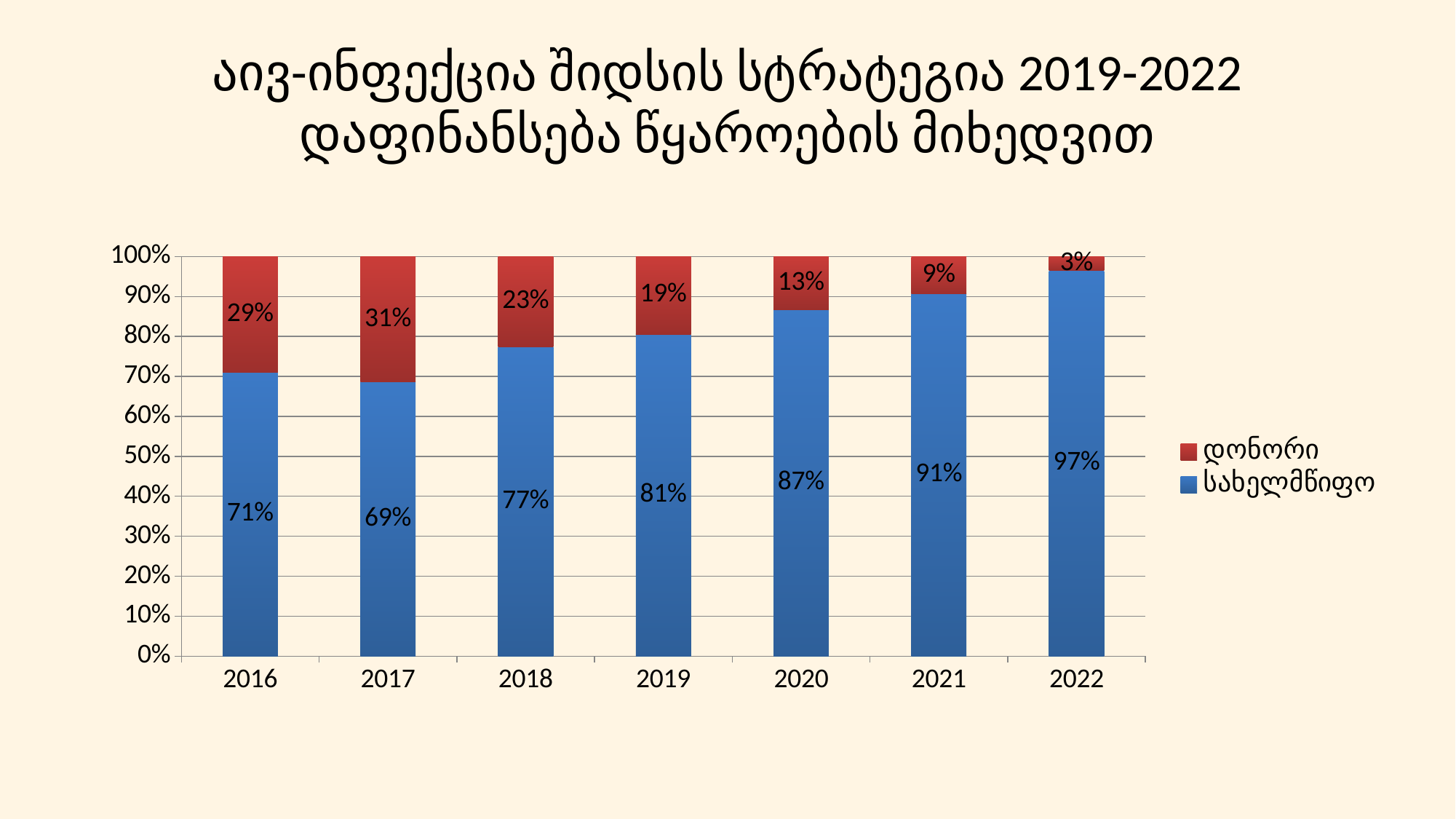
How many years are shown on the x axis? 7 Which is larger: the დონორი value in 2018 or in 2019? 2018 In which year is the სახელმწიფო share highest? 2022 Does the დონორი share rise or fall from 2017 to 2022? Fall What is the value for დონორი in 2017? 31% How many series does the legend list? 2 What kind of chart is shown on the slide? Stacked bar chart What is the value for დონორი in 2022? 3% What is the value for სახელმწიფო in 2016? 71% What is the difference between the სახელმწიფო value in 2022 and in 2016? 26% What is the value for სახელმწიფო in 2020? 87% In which year is the სახელმწიფო share lowest? 2017